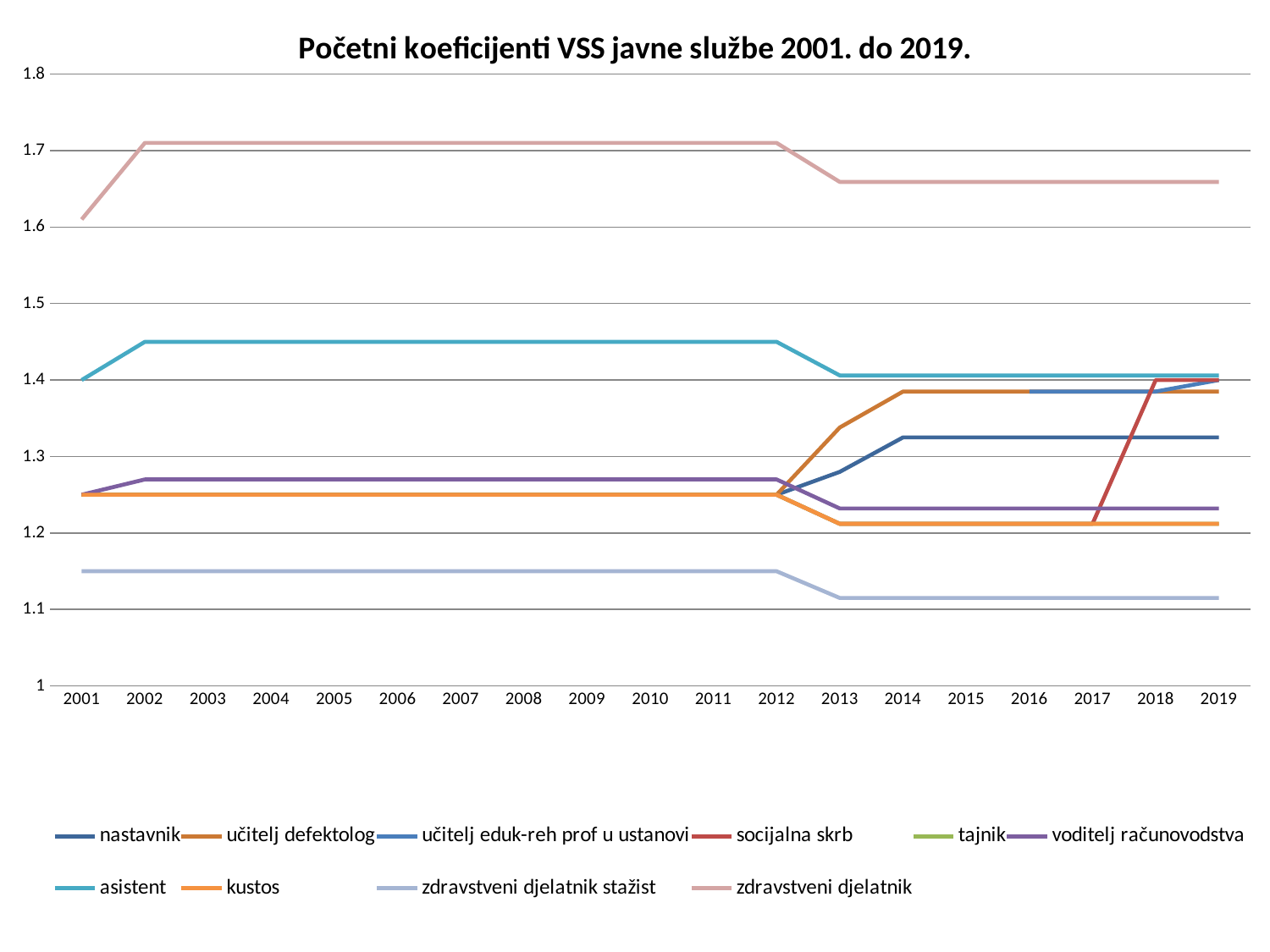
Does the value for socijalna skrb rise or fall from 2017 to 2018? rise What kind of chart is shown on the slide? line chart How many years are shown on the x axis? 19 What is the title of the chart? Početni koeficijenti VSS javne službe 2001. do 2019. Is the value for asistent in 2005 greater or less than 1.5? less How many series does the legend list? 10 In 2019, which is larger: the value for asistent or the value for kustos? asistent Which series has the highest values across the whole period? zdravstveni djelatnik Is the value for zdravstveni djelatnik stažist in 2015 greater or less than 1.2? less Does the value for zdravstveni djelatnik stažist rise or fall from 2012 to 2013? fall Which series has the lowest values across the whole period? zdravstveni djelatnik stažist Is the value for zdravstveni djelatnik in 2010 greater or less than 1.6? greater